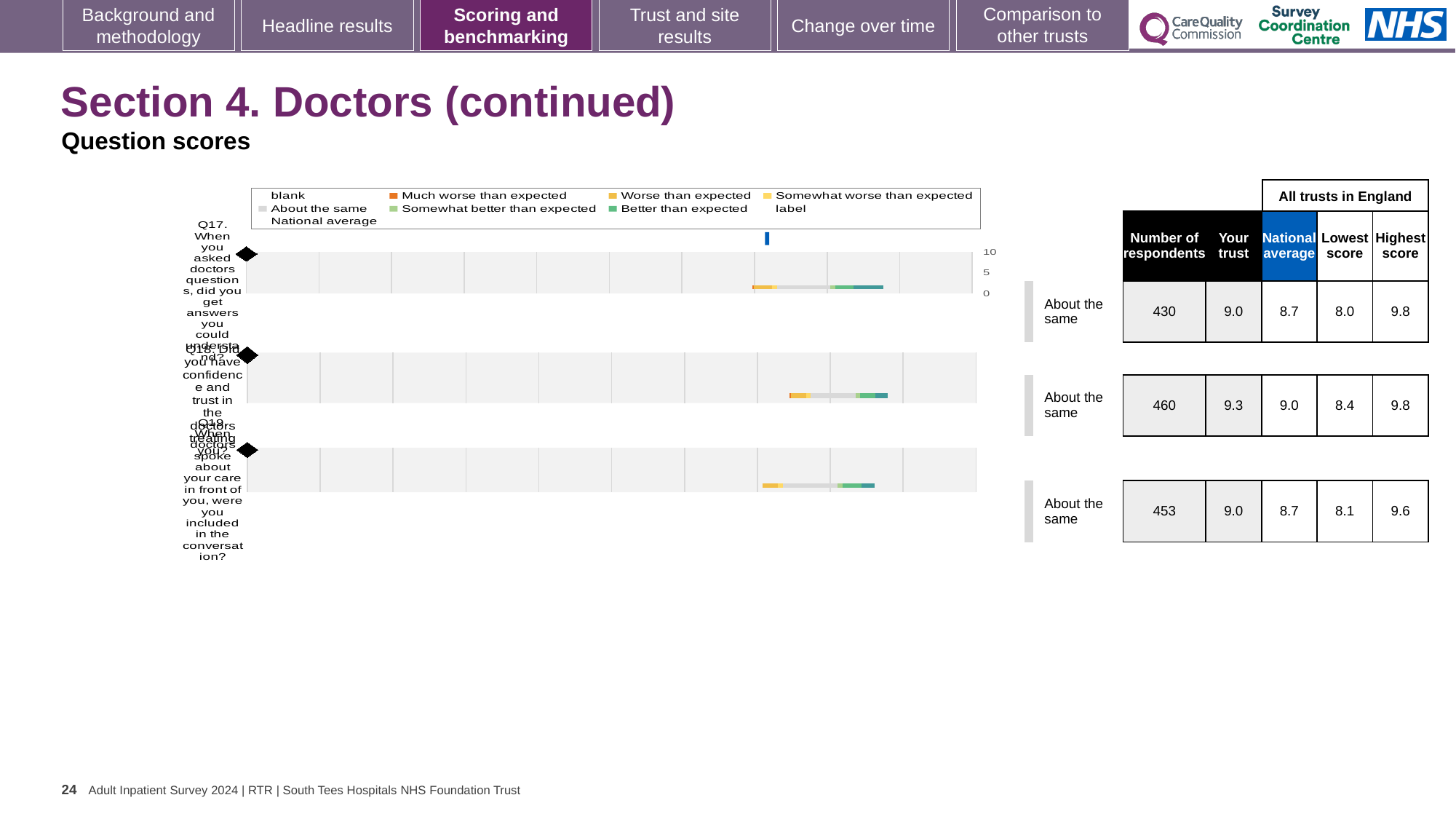
What is the difference between the 'Your trust' score and the national average for Q18? 0.3 What is the national average score for Q17? 8.7 How many respondents answered Q19? 453 How many questions (categories) are plotted in the chart? 3 What benchmark category is shown for all three questions? About the same Which question has the lowest 'Lowest score' across all trusts in England? Q17 Which question has the highest 'Your trust' score? Q18 What is the 'Your trust' score for Q18 (confidence and trust in doctors)? 9.3 What kind of chart is shown on the slide? bar chart For Q17, which is larger: the 'Your trust' score or the national average? Your trust What is the subtitle of the chart section on the slide? Question scores What is the highest score among all trusts in England for Q19? 9.6